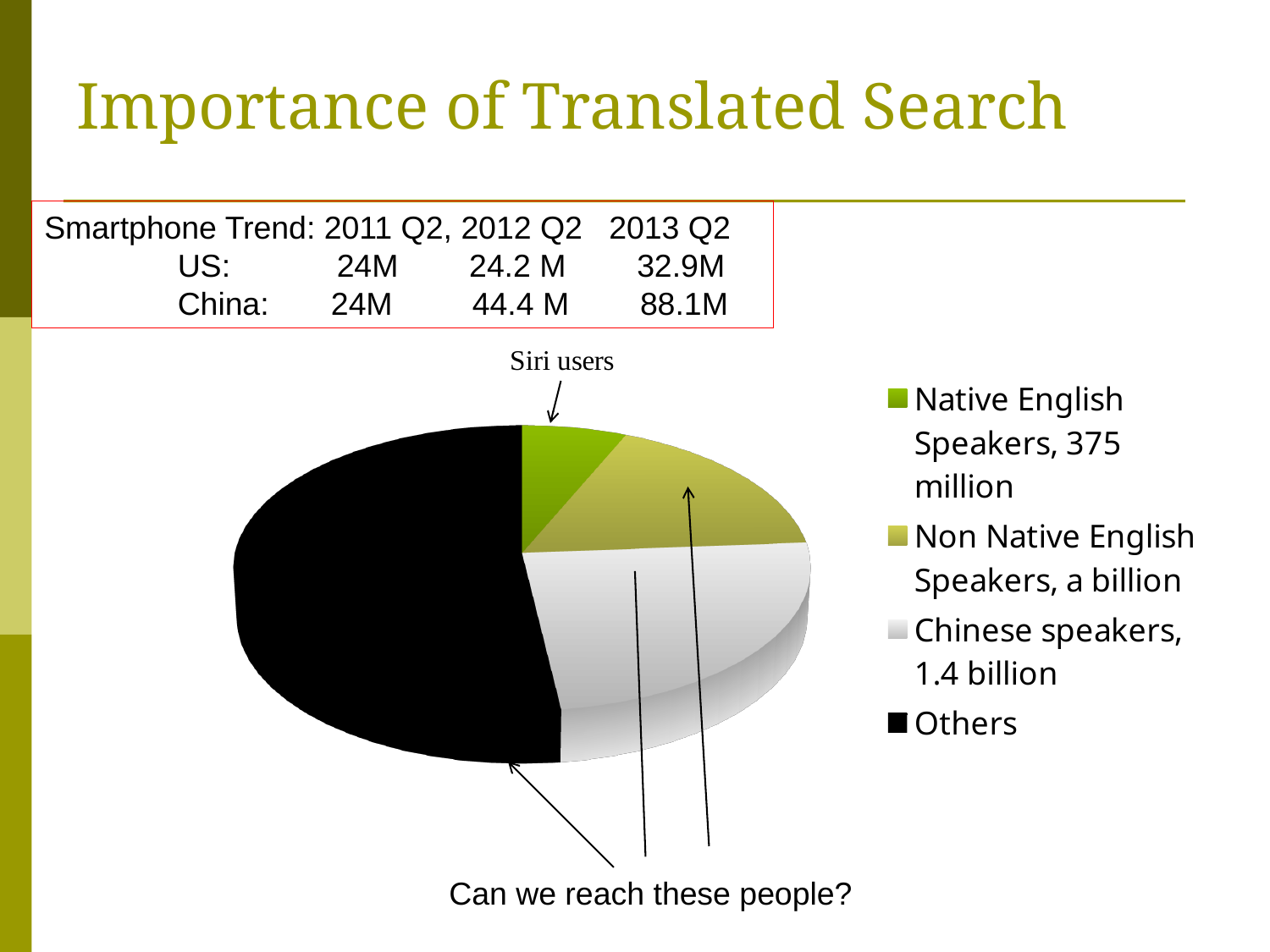
How many entries does the legend of the pie chart list? 4 According to the legend, how many Native English Speakers are there? 375 million What kind of chart is shown on the slide? pie chart According to the legend, how many Non Native English Speakers are there? a billion How many slices does the pie chart have? 4 According to the legend, how many Chinese speakers are there? 1.4 billion Which slice of the pie chart is the smallest? Native English Speakers Which slice does the 'Siri users' annotation point to? Native English Speakers Which slice is larger: Others or Non Native English Speakers? Others Which slice is larger: Chinese speakers or Native English Speakers? Chinese speakers What colour is the Others slice in the pie chart? black Which slice of the pie chart is the largest? Others